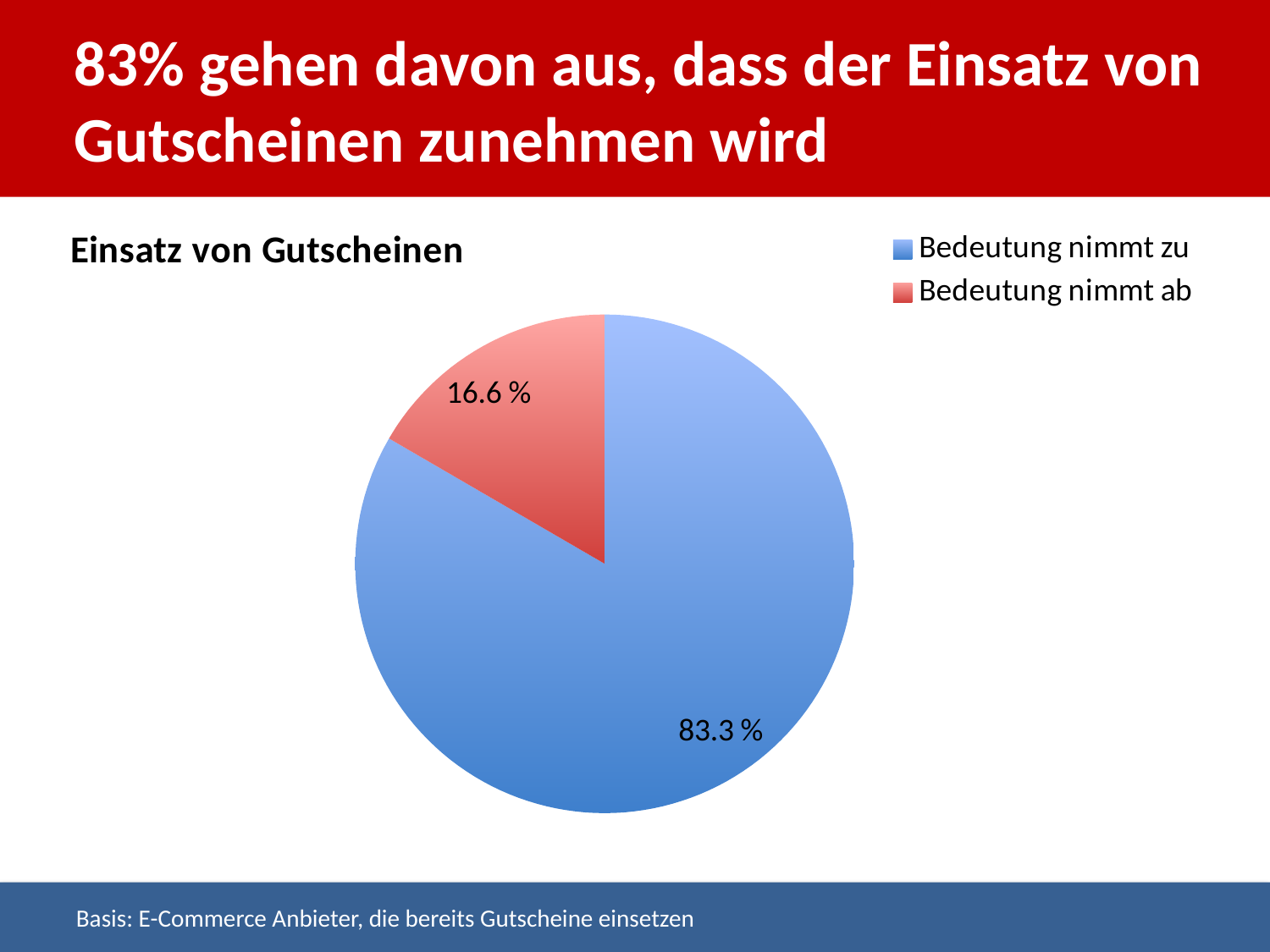
What is the title of the chart? Einsatz von Gutscheinen What is the difference in percentage points between the "Bedeutung nimmt zu" and "Bedeutung nimmt ab" slices? 66.7 What share of the pie is labelled "Bedeutung nimmt zu"? 83.3 % Which slice of the pie is the largest? Bedeutung nimmt zu What share of the pie is labelled "Bedeutung nimmt ab"? 16.6 % What type of chart is shown on the slide? pie chart What colour is the "Bedeutung nimmt ab" slice? red How many entries does the legend list? 2 Which is larger: the "Bedeutung nimmt zu" slice or the "Bedeutung nimmt ab" slice? Bedeutung nimmt zu How many slices does the pie chart have? 2 Which slice of the pie is the smallest? Bedeutung nimmt ab